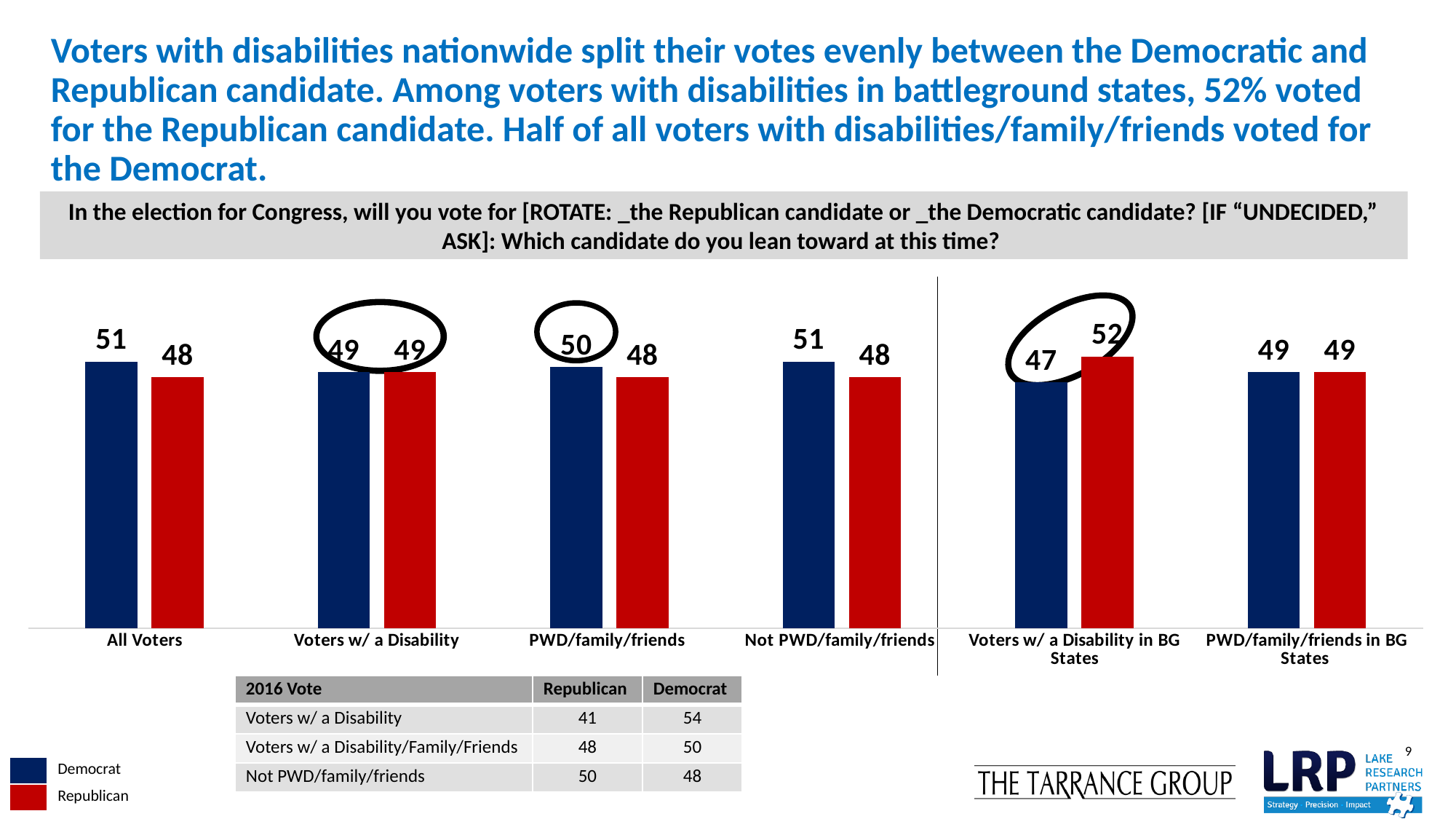
What is the Democrat value for PWD/family/friends? 50 What is the Democrat value for All Voters? 51 Which category has the highest Republican value? Voters w/ a Disability in BG States What is the difference between the Republican and Democrat values for Voters w/ a Disability in BG States? 5 How many categories are shown on the x axis of the chart? 6 Which category has the lowest Democrat value? Voters w/ a Disability in BG States What is the Republican value for Voters w/ a Disability in BG States? 52 What kind of chart is shown on the slide? Bar chart Which colour represents the Republican series in the chart? Red How many series does the legend list? 2 For All Voters, which is larger, the Democrat value or the Republican value? Democrat What is the Republican value for Not PWD/family/friends? 48